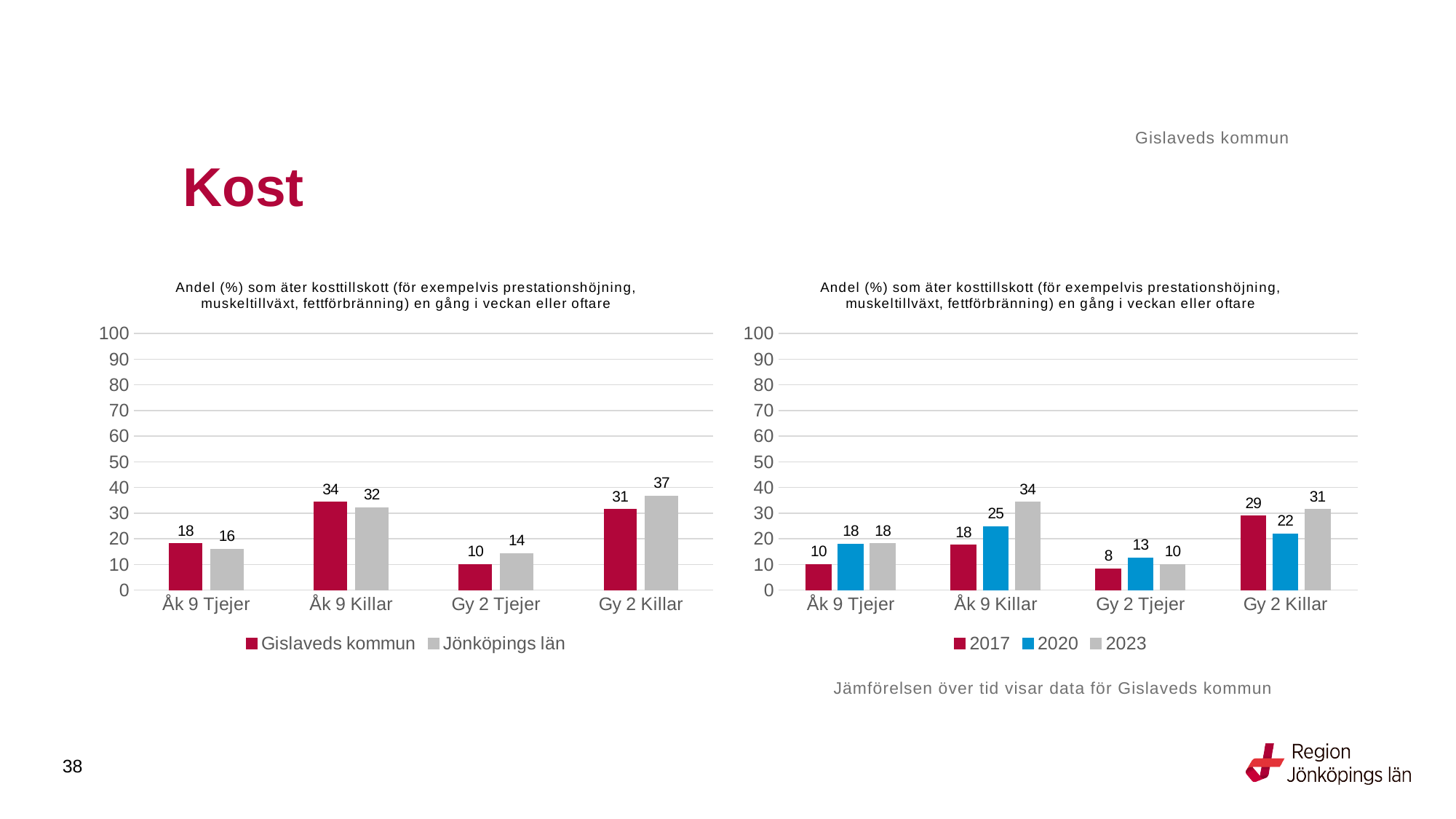
In the left chart, which category has the highest value for Jönköpings län? Gy 2 Killar In the right chart, what is the difference between 2023 and 2017 for Åk 9 Killar? 16 In the right chart, how many series does the legend list? 3 In the left chart, what is the difference between Jönköpings län and Gislaveds kommun for Gy 2 Killar? 6 In the left chart, what is the value for Jönköpings län for Gy 2 Tjejer? 14 In the left chart, what is the value for Gislaveds kommun for Åk 9 Killar? 34 In the right chart, what is the value for 2017 for Gy 2 Tjejer? 8 In the right chart, what is the value for 2020 for Åk 9 Killar? 25 What kind of chart is the left chart? Bar chart In the left chart, which is larger for Åk 9 Tjejer: Gislaveds kommun or Jönköpings län? Gislaveds kommun In the left chart, which category has the lowest value for Gislaveds kommun? Gy 2 Tjejer In the right chart, which category has the highest value for 2023? Åk 9 Killar